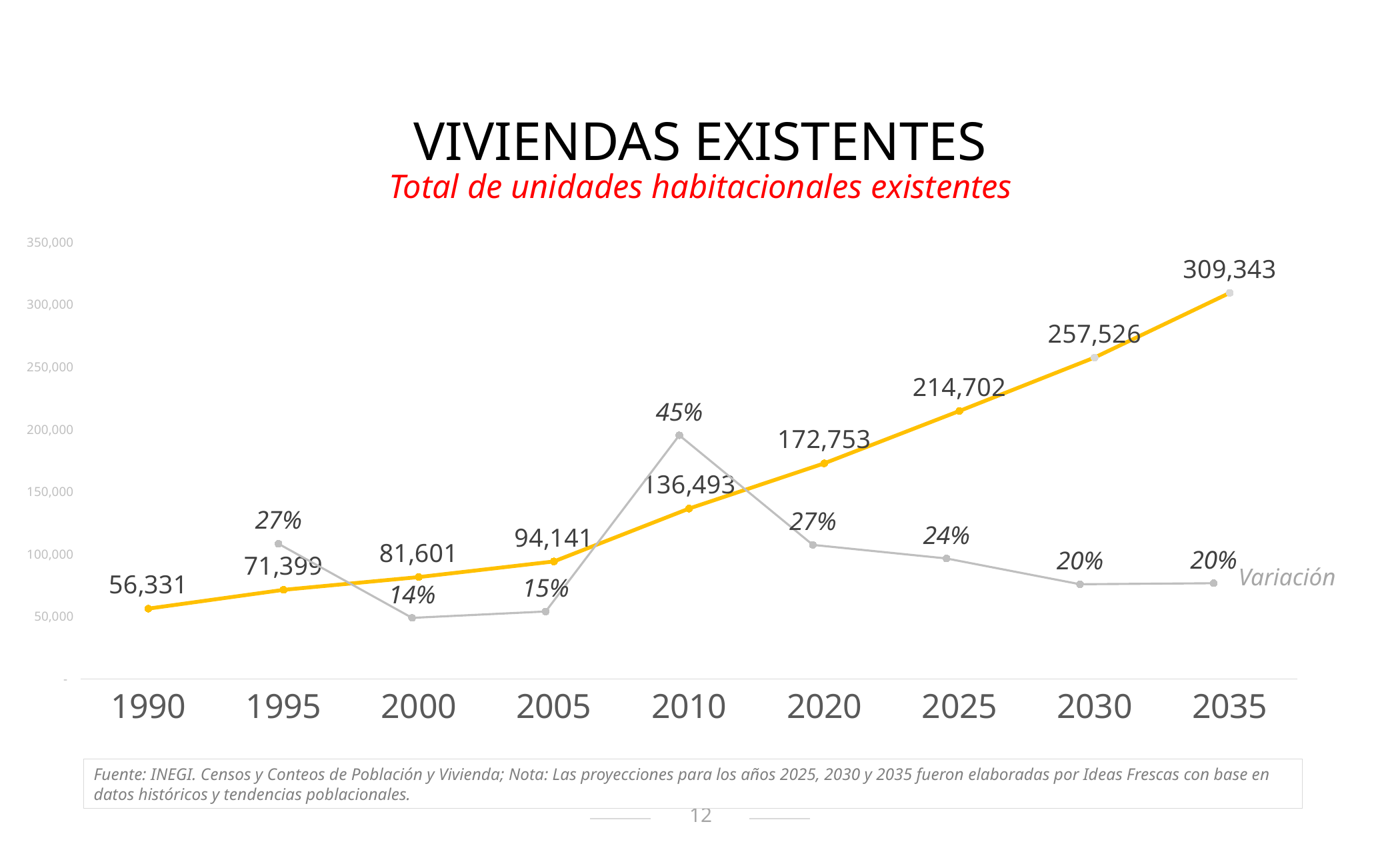
Does the housing units series rise or fall from 1990 to 2035? Rise Which year has the highest number of existing housing units? 2035 What is the number of existing housing units shown for 2010? 136,493 What is the value of the housing units series for 1990? 56,331 Is the value for housing units in 2025 greater or less than 200,000? greater What is the Variación percentage shown for 2000? 14% Which is larger, the Variación for 1995 or for 2025? 1995 What is the difference between the housing units in 2035 and in 2030? 51,817 Which year has the lowest Variación percentage? 2000 How many years are shown on the x axis? 9 What kind of chart is shown on the slide? Line chart What is the Variación percentage shown for 2010? 45%